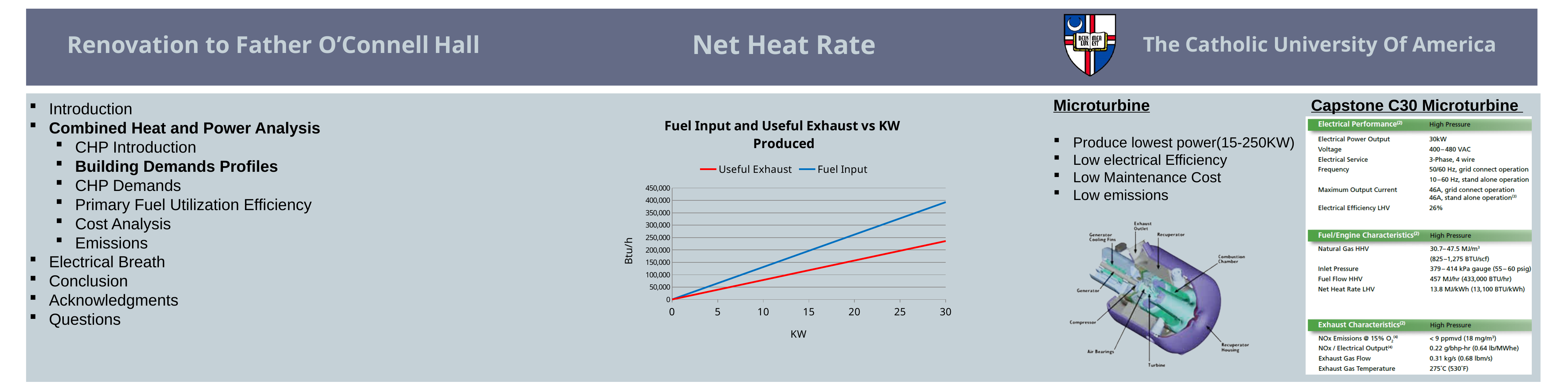
Do the values of the Fuel Input series rise or fall as KW increases along the x axis? rise What is the label of the y axis of the chart? Btu/h Is the value of Fuel Input at 30 KW greater or less than 350,000? greater Is the value of Fuel Input at 15 KW greater or less than 150,000? greater What is the title of the chart? Fuel Input and Useful Exhaust vs KW Produced Is the value of Useful Exhaust at 15 KW greater or less than 150,000? less At 30 KW, which series has the larger value, Fuel Input or Useful Exhaust? Fuel Input Which series in the chart is the higher line across the whole x axis range? Fuel Input What kind of chart is shown on the slide? line chart How many series does the legend of the chart list? 2 Do the values of the Useful Exhaust series rise or fall as KW increases along the x axis? rise